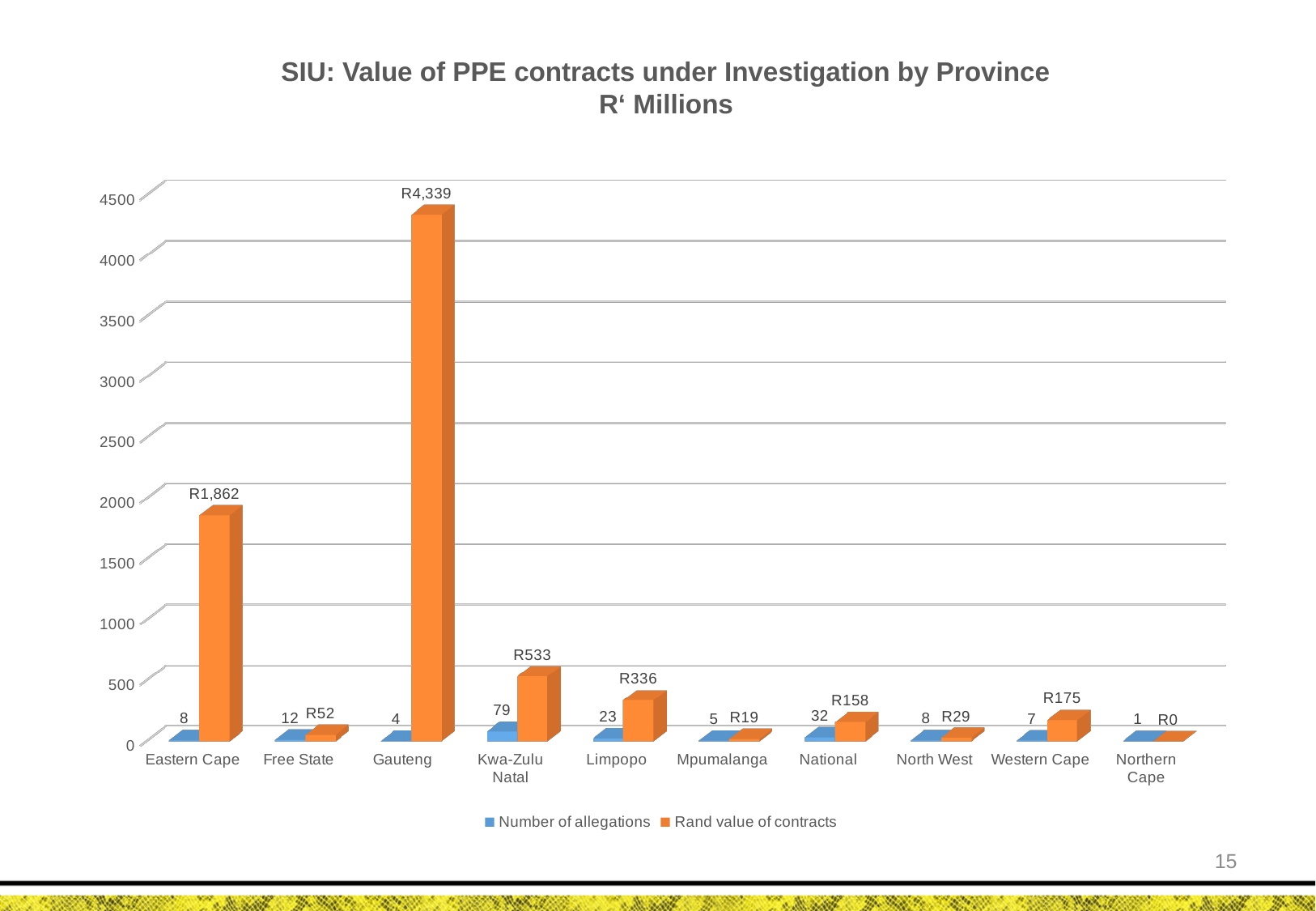
How many series does the legend list? 2 Which has a larger Rand value of contracts, Kwa-Zulu Natal or Limpopo? Kwa-Zulu Natal Which category has the lowest Rand value of contracts? Northern Cape How many categories are shown on the x axis? 10 Which category has the highest number of allegations? Kwa-Zulu Natal What is the difference between the Rand value of contracts for Gauteng and Eastern Cape? R2,477 What is the number of allegations for Kwa-Zulu Natal? 79 What kind of chart is shown on the slide? Bar chart Which province has the highest Rand value of contracts? Gauteng What is the Rand value of contracts for Gauteng? R4,339 What is the Rand value of contracts for Eastern Cape? R1,862 What is the difference in number of allegations between National and Limpopo? 9